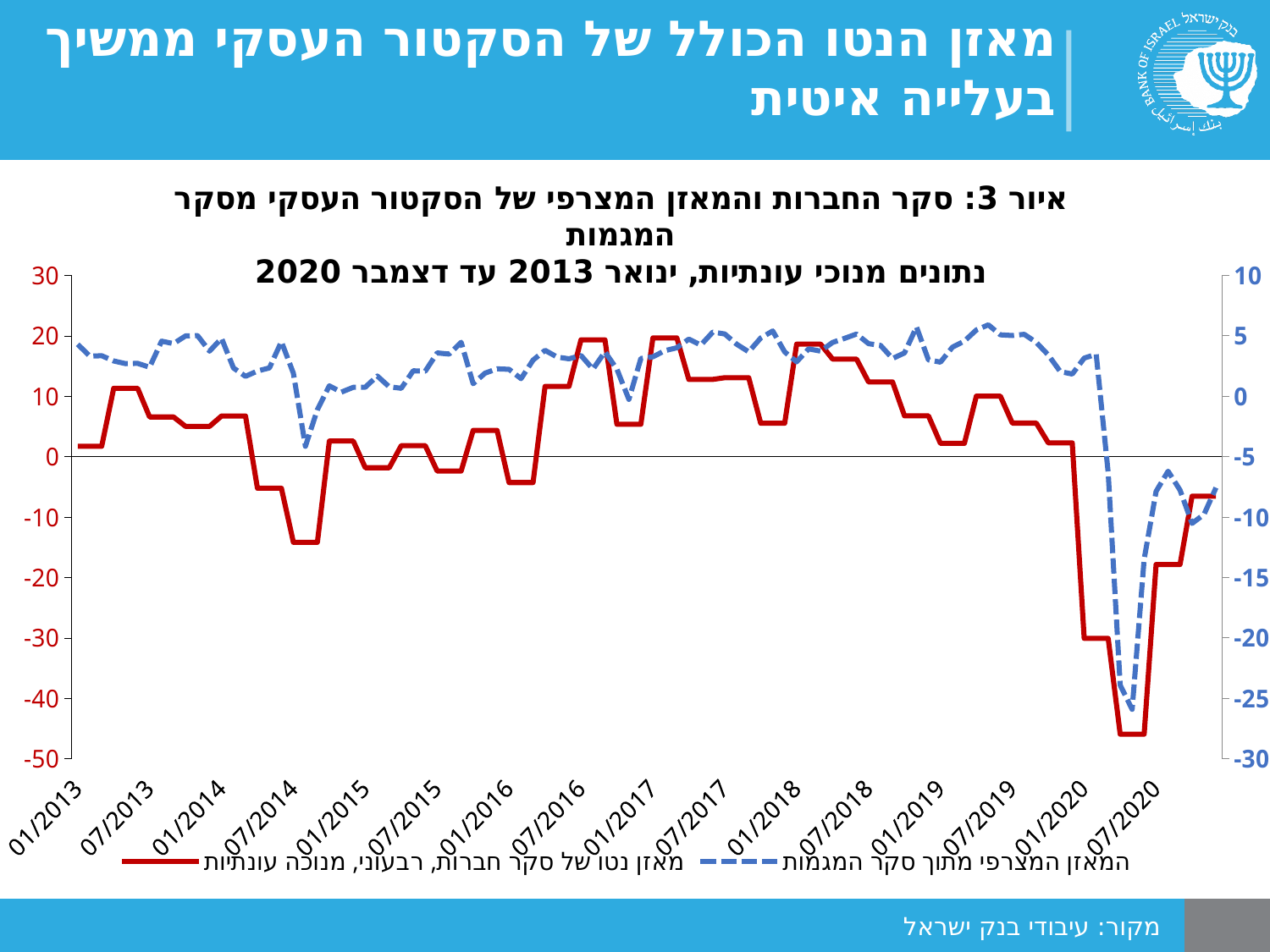
How many date labels are shown along the x axis? 16 How many series does the legend list? 2 What kind of chart is shown on the slide? line chart Is the lowest value of the blue dashed line (right axis) greater or less than -20? less Between 01/2020 and the middle of 2020, do the values of the red solid line rise or fall? fall Is the lowest value of the red solid line (left axis) greater or less than -40? less Is the value of the red solid line at 01/2013 (left axis) greater or less than 0? greater Which series is drawn as a dashed blue line? המאזן המצרפי מתוך סקר המגמות What is the first date label on the x axis? 01/2013 After reaching their lowest point in 2020, do the values of the blue dashed line rise or fall toward the end of the series? rise